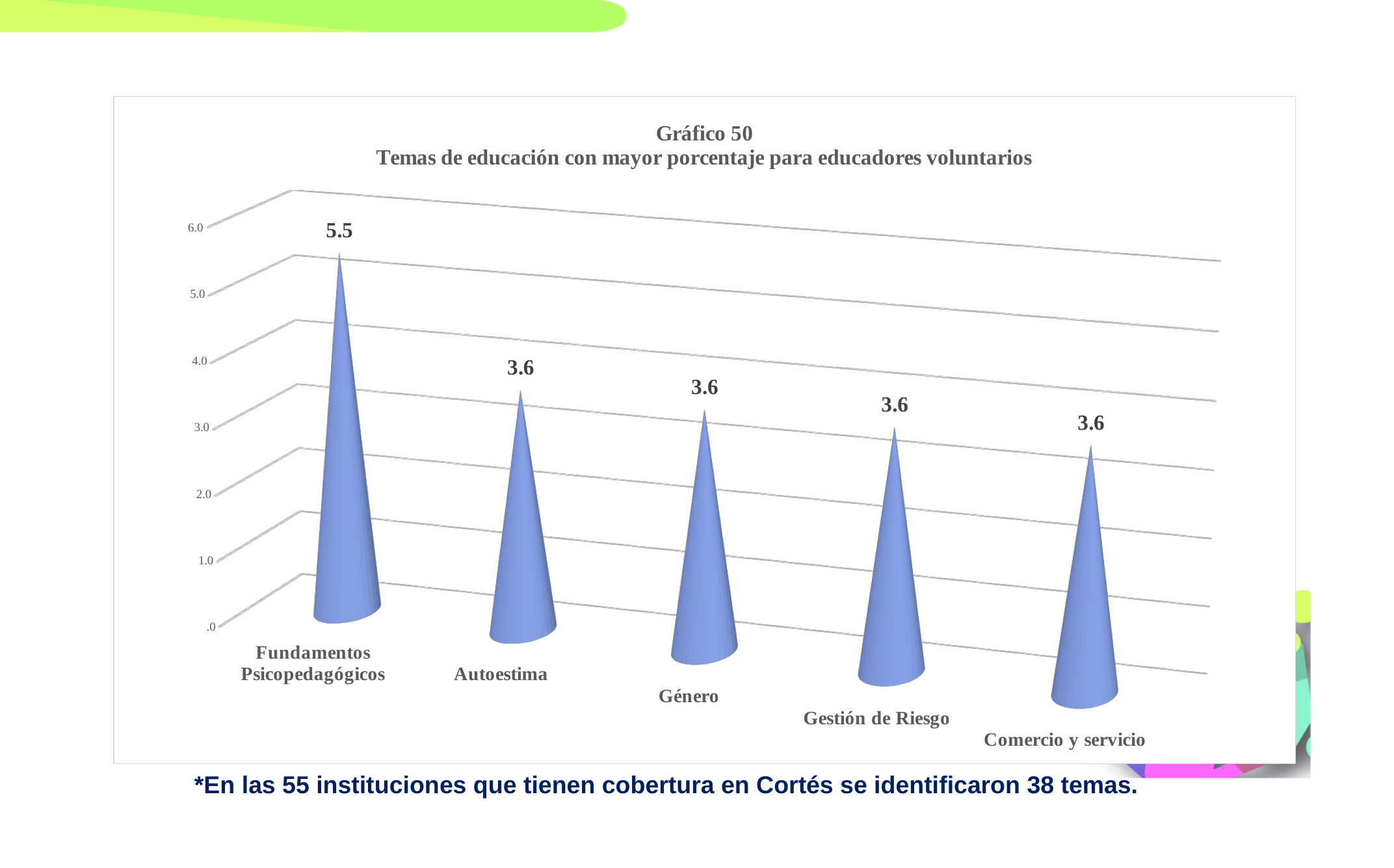
What kind of chart is shown on the slide? bar chart What is the value for Comercio y servicio? 3.6 Which category has the highest value? Fundamentos Psicopedagógicos Is the value for Fundamentos Psicopedagógicos greater or less than 5.0? greater What is the value for Autoestima? 3.6 How many categories are shown in the chart? 5 Is the value for Género greater or less than 3.0? greater What is the title of the chart? Gráfico 50 Temas de educación con mayor porcentaje para educadores voluntarios What is the value for Gestión de Riesgo? 3.6 What is the difference between the values for Fundamentos Psicopedagógicos and Género? 1.9 What is the value for Fundamentos Psicopedagógicos? 5.5 Which is larger, the value for Fundamentos Psicopedagógicos or the value for Autoestima? Fundamentos Psicopedagógicos